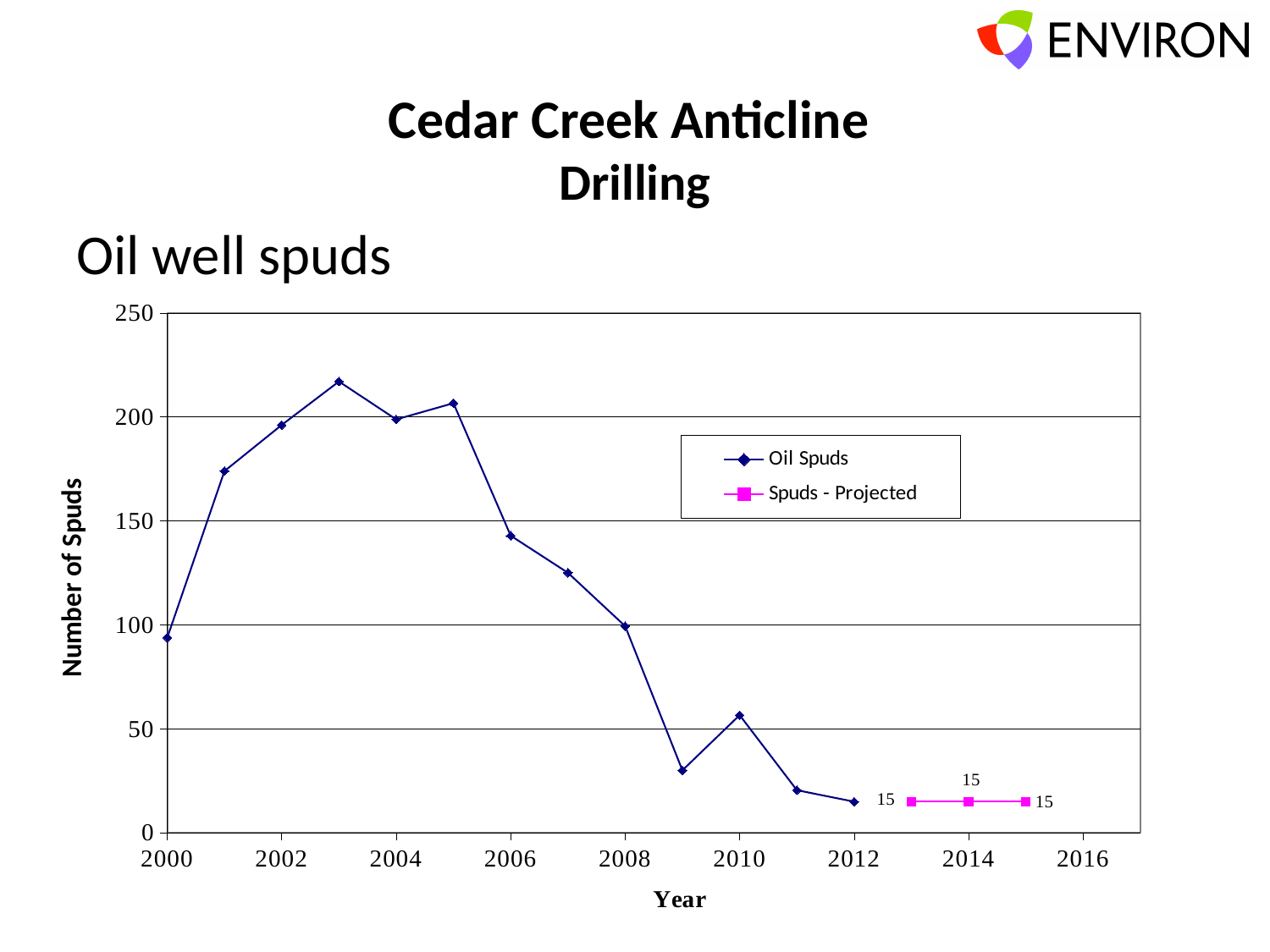
Do the Oil Spuds values rise or fall from 2005 to 2009? fall What is the title of the y axis? Number of Spuds Is the value for Oil Spuds in 2001 greater or less than 150? greater What kind of chart is shown on the slide? line chart What is the projected number of spuds for 2014? 15 What is the projected number of spuds for 2015? 15 How many series does the legend list? 2 Which year has the larger Oil Spuds value, 2005 or 2006? 2005 How many data points does the Spuds - Projected series have? 3 Is the value for Oil Spuds in 2003 greater or less than 200? greater In which year is the Oil Spuds value highest? 2003 Is the value for Oil Spuds in 2009 greater or less than 50? less